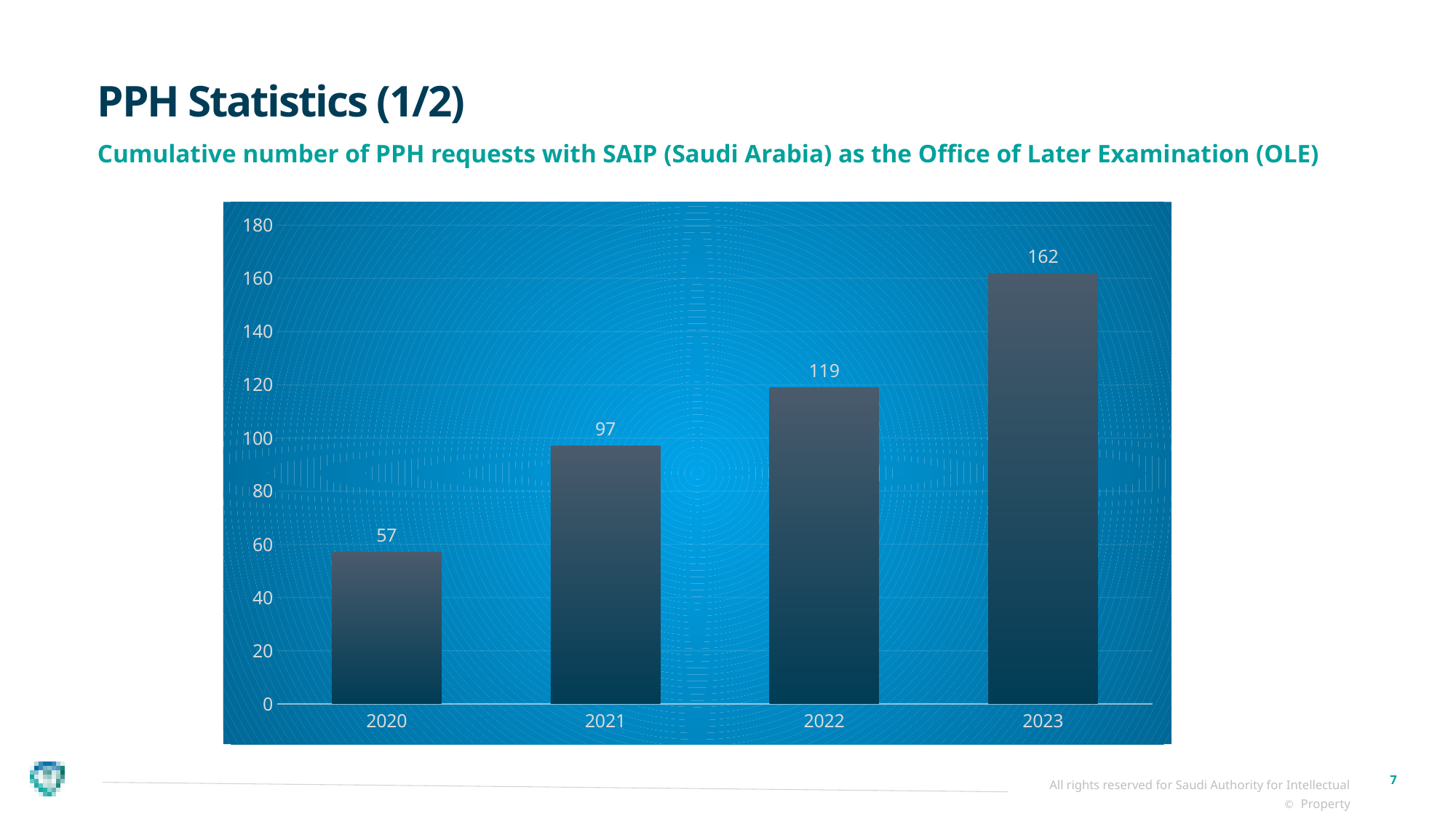
What is the cumulative number of PPH requests for 2021? 97 What is the difference between the values for 2021 and 2020? 40 Which year has the lowest cumulative number of PPH requests? 2020 Which is larger, the value for 2021 or the value for 2022? 2022 What is the cumulative number of PPH requests for 2022? 119 What is the cumulative number of PPH requests for 2023? 162 Which year has the highest cumulative number of PPH requests? 2023 Do the values rise or fall from 2020 to 2023? Rise What kind of chart is shown on the slide? Bar chart What is the difference between the values for 2023 and 2022? 43 What is the cumulative number of PPH requests for 2020? 57 How many years are shown on the x axis of the chart? 4